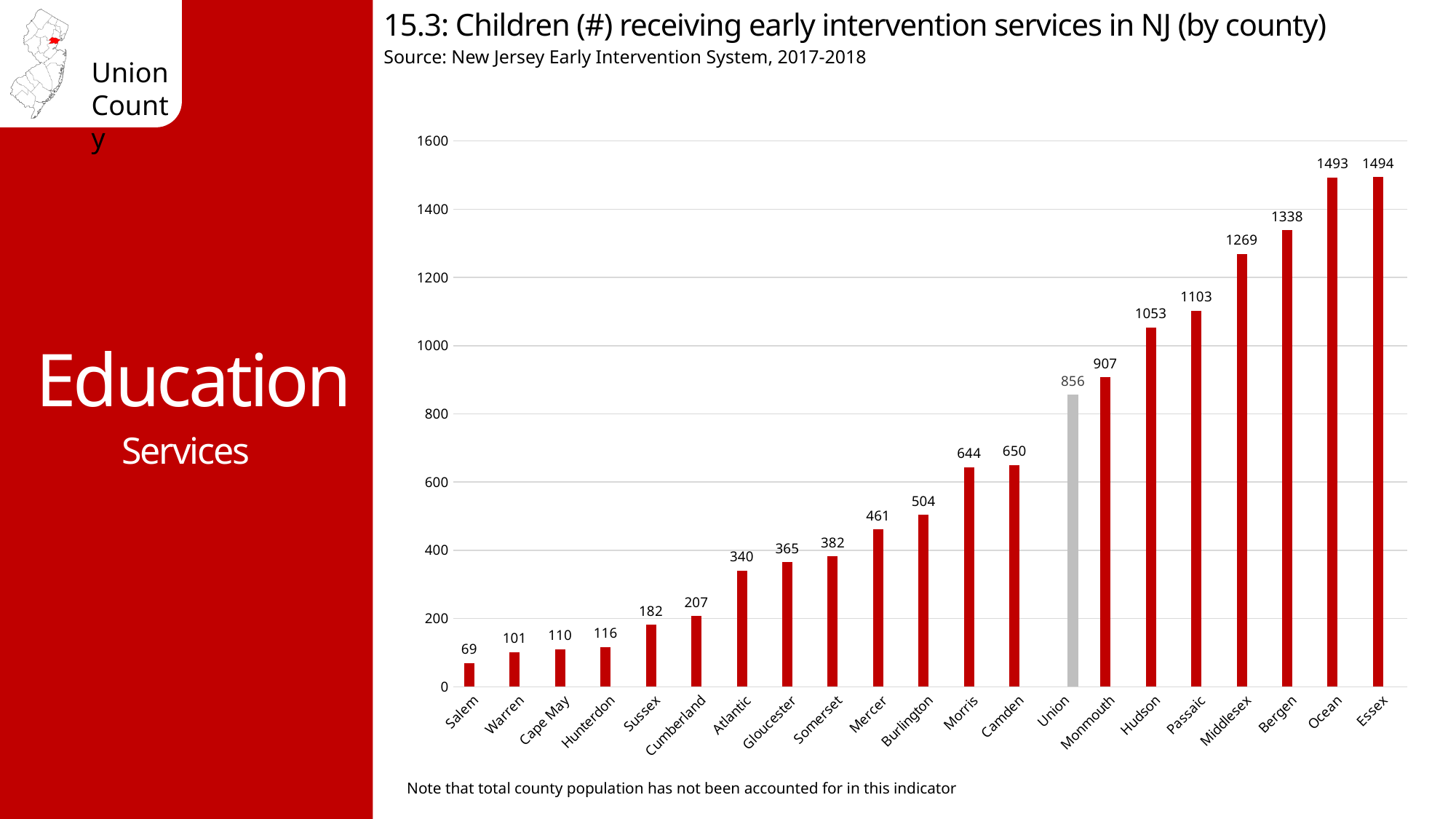
Is the value for Passaic greater or less than 1000? greater What is the value shown for Bergen County? 1338 How many counties are shown on the chart? 21 What is the value shown for Cumberland County? 207 How many children in Union County are receiving early intervention services? 856 Do the values rise or fall moving from left to right along the x axis? Rise What kind of chart is shown on the slide? Bar chart Which county has a higher value, Hudson or Camden? Hudson Which county's bar is shown in grey rather than red? Union What is the difference between the values for Essex and Salem? 1425 What is the difference between the values for Monmouth and Union? 51 Which county has the lowest number of children receiving early intervention services? Salem